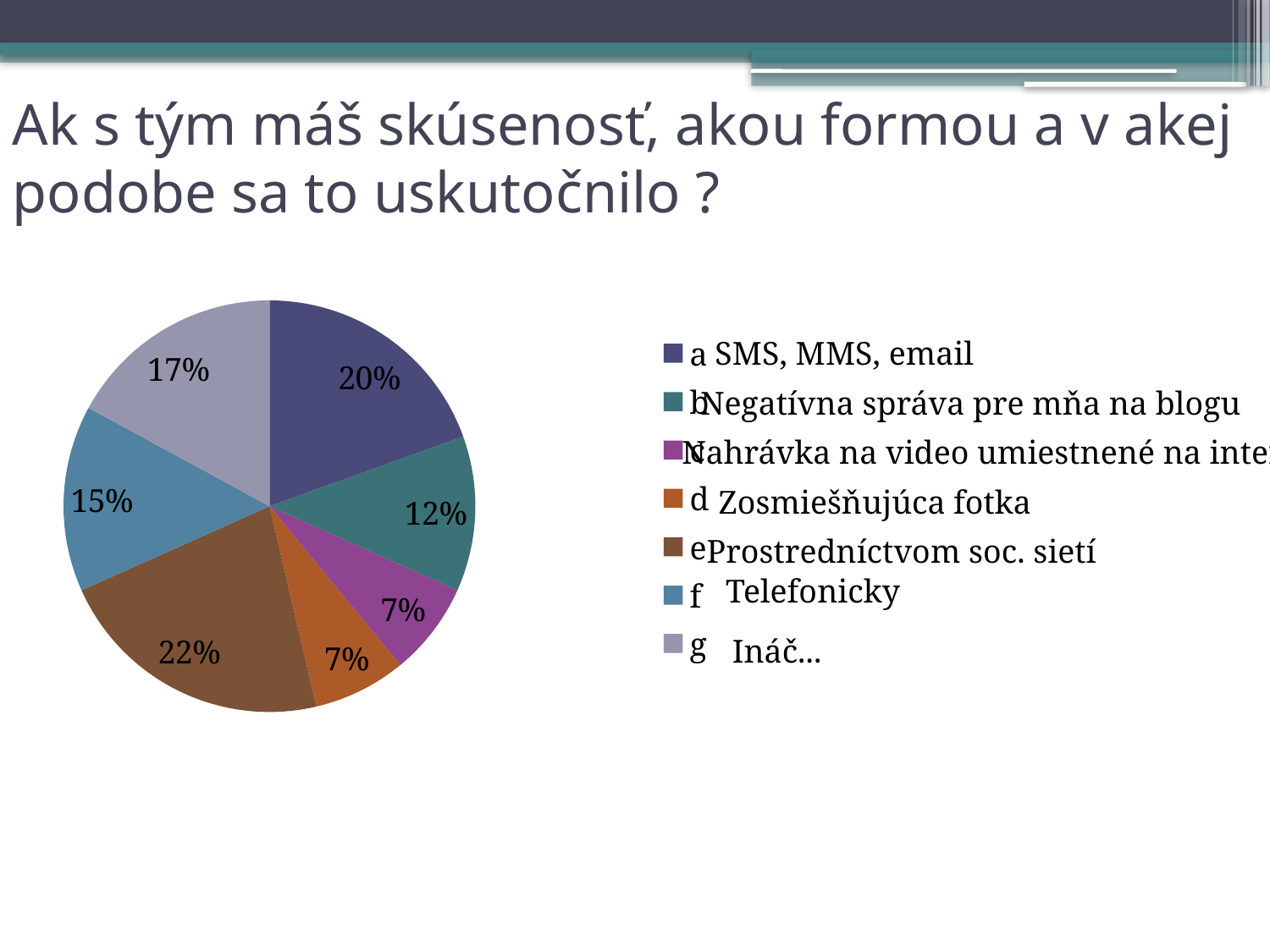
How many slices does the pie chart have? 7 What share of the pie does category g (Ináč...) have? 17% What share of the pie does category e (Prostredníctvom soc. sietí) have? 22% What is the difference between the share for e (Prostredníctvom soc. sietí) and the share for f (Telefonicky)? 7% What share of the pie does category b (Negatívna správa pre mňa na blogu) have? 12% Which is larger, the share for a (SMS, MMS, email) or the share for g (Ináč...)? a SMS, MMS, email What is the smallest share shown on the pie chart? 7% Which category has the largest share of the pie? e Prostredníctvom soc. sietí What kind of chart is shown on the slide? pie chart How many entries does the legend list? 7